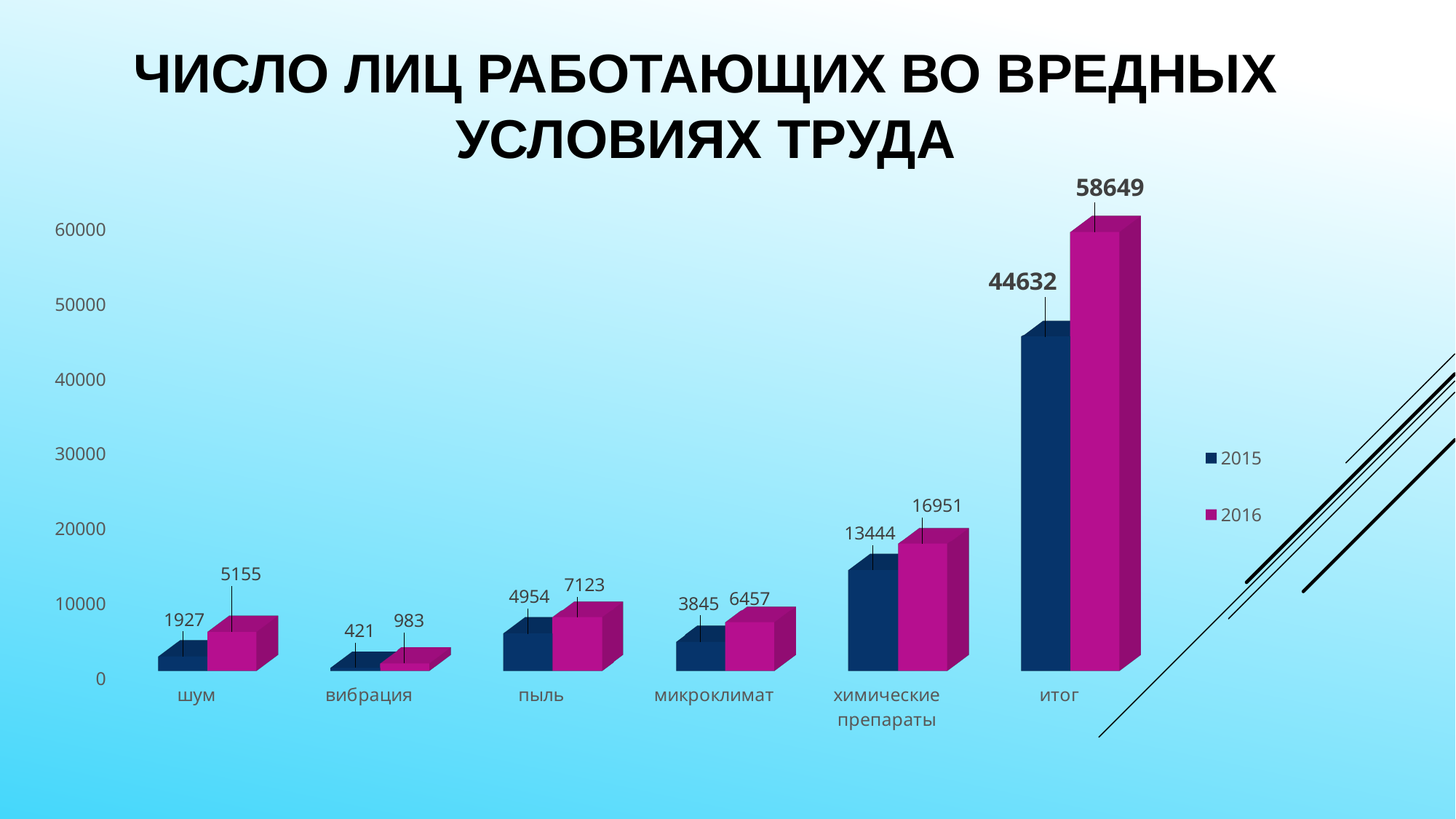
What is the value for шум in 2015? 1927 What kind of chart is shown on the slide? bar chart Which category has the lowest value in 2015? вибрация What is the difference between the 2016 and 2015 values for пыль? 2169 Which category has the highest value in 2016? итог What is the difference between the 2016 and 2015 values for итог? 14017 How many series does the legend list? 2 Which is larger for микроклимат: the 2015 value or the 2016 value? 2016 What is the value for итог in 2015? 44632 What is the value for вибрация in 2016? 983 What is the value for химические препараты in 2016? 16951 How many categories are shown on the x axis? 6